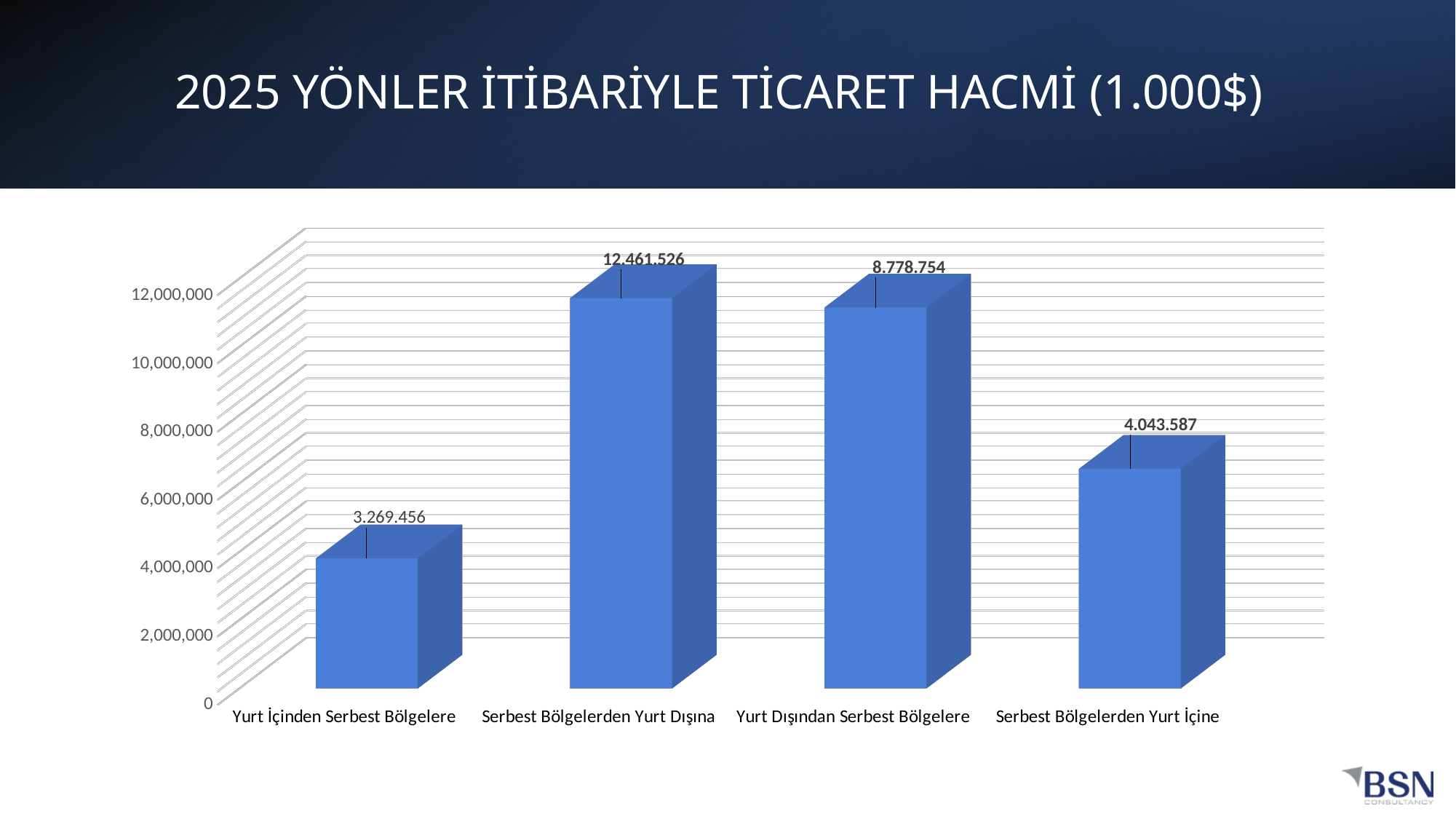
How many categories are shown on the x axis? 4 Which is larger, the value for Yurt Dışından Serbest Bölgelere or the value for Serbest Bölgelerden Yurt İçine? Yurt Dışından Serbest Bölgelere Which category has the highest value? Serbest Bölgelerden Yurt Dışına What is the value for Serbest Bölgelerden Yurt İçine? 4.043.587 Is the value for Serbest Bölgelerden Yurt Dışına greater or less than 10,000,000? greater What is the value for Yurt İçinden Serbest Bölgelere? 3.269.456 What kind of chart is shown on the slide? bar chart What is the difference between the values for Serbest Bölgelerden Yurt Dışına and Yurt Dışından Serbest Bölgelere? 3.682.772 What is the value for Yurt Dışından Serbest Bölgelere? 8.778.754 What is the value for Serbest Bölgelerden Yurt Dışına? 12.461.526 Which category has the lowest value? Yurt İçinden Serbest Bölgelere What is the difference between the values for Serbest Bölgelerden Yurt İçine and Yurt İçinden Serbest Bölgelere? 774.131